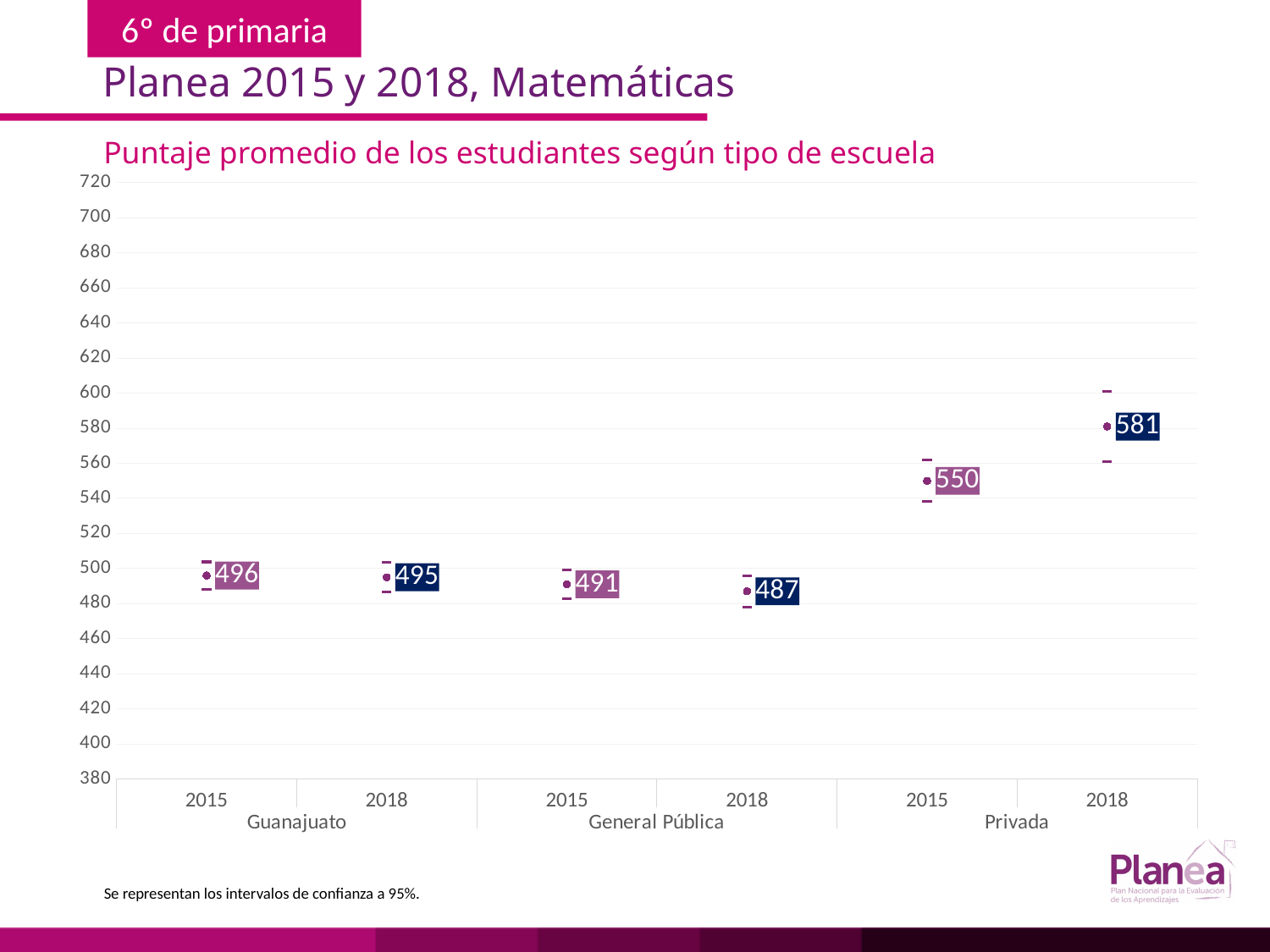
What is the difference between the Guanajuato score in 2015 and the General Pública score in 2015? 5 Which school type and year has the lowest average score? General Pública 2018 Which is larger, the Guanajuato score in 2018 or the General Pública score in 2018? Guanajuato 2018 What is the average score for General Pública in 2018? 487 What is the average score for Guanajuato in 2015? 496 What is the average score for Privada in 2015? 550 Which school type and year has the highest average score? Privada 2018 What is the difference between the Privada scores in 2018 and 2015? 31 What is the average score for Privada in 2018? 581 How many data points are plotted on the chart? 6 Did the Privada average score rise or fall from 2015 to 2018? Rise What is the title of the chart? Puntaje promedio de los estudiantes según tipo de escuela